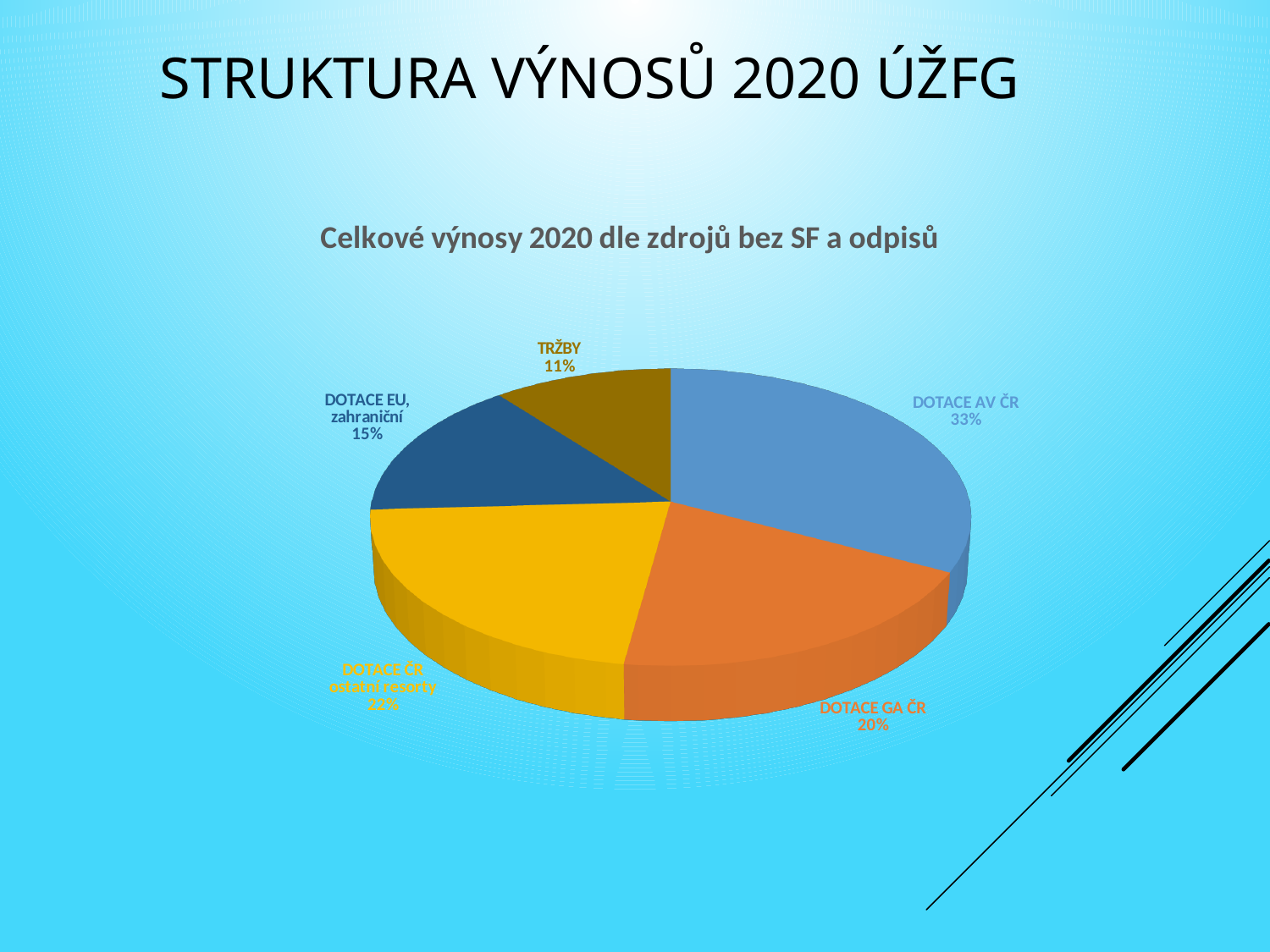
What share of the pie does DOTACE AV ČR represent? 33% What kind of chart is shown on the slide? Pie chart What share of the pie does DOTACE EU, zahraniční represent? 15% Which category has the largest share of the pie? DOTACE AV ČR What share of the pie does DOTACE ČR ostatní resorty represent? 22% What is the title of the chart? Celkové výnosy 2020 dle zdrojů bez SF a odpisů Which is larger, the share for DOTACE ČR ostatní resorty or the share for DOTACE GA ČR? DOTACE ČR ostatní resorty How many slices does the pie chart have? 5 Which category has the smallest share of the pie? TRŽBY What is the difference in percentage points between DOTACE AV ČR and TRŽBY? 22